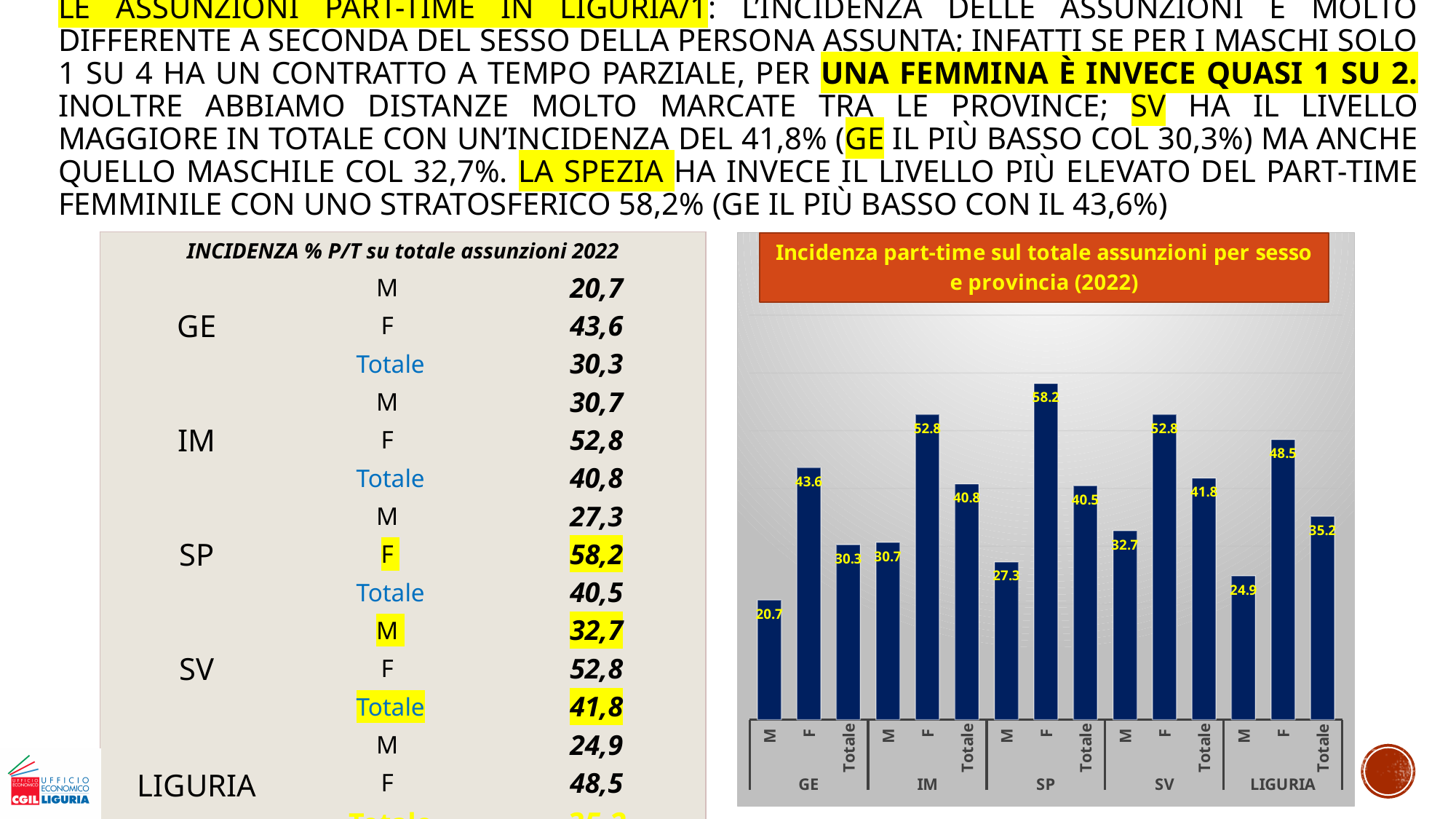
What is the difference between the F bar and the M bar for SP in the chart? 30.9 Which is larger in the chart: the Totale bar for IM or the Totale bar for SP? IM Totale What is the title of the chart? Incidenza part-time sul totale assunzioni per sesso e provincia (2022) Which bar in the chart has the highest value? SP F What is the value of the F bar for LIGURIA in the chart? 48.5 What is the value of the Totale bar for SV in the chart? 41.8 How many provinces/groups are shown on the x axis of the chart? 5 What type of chart is shown on the slide? bar chart How many bars are plotted in the chart in total? 15 What is the value of the F bar for SP in the chart? 58.2 Which bar in the chart has the lowest value? GE M What is the value of the M bar for GE in the chart? 20.7